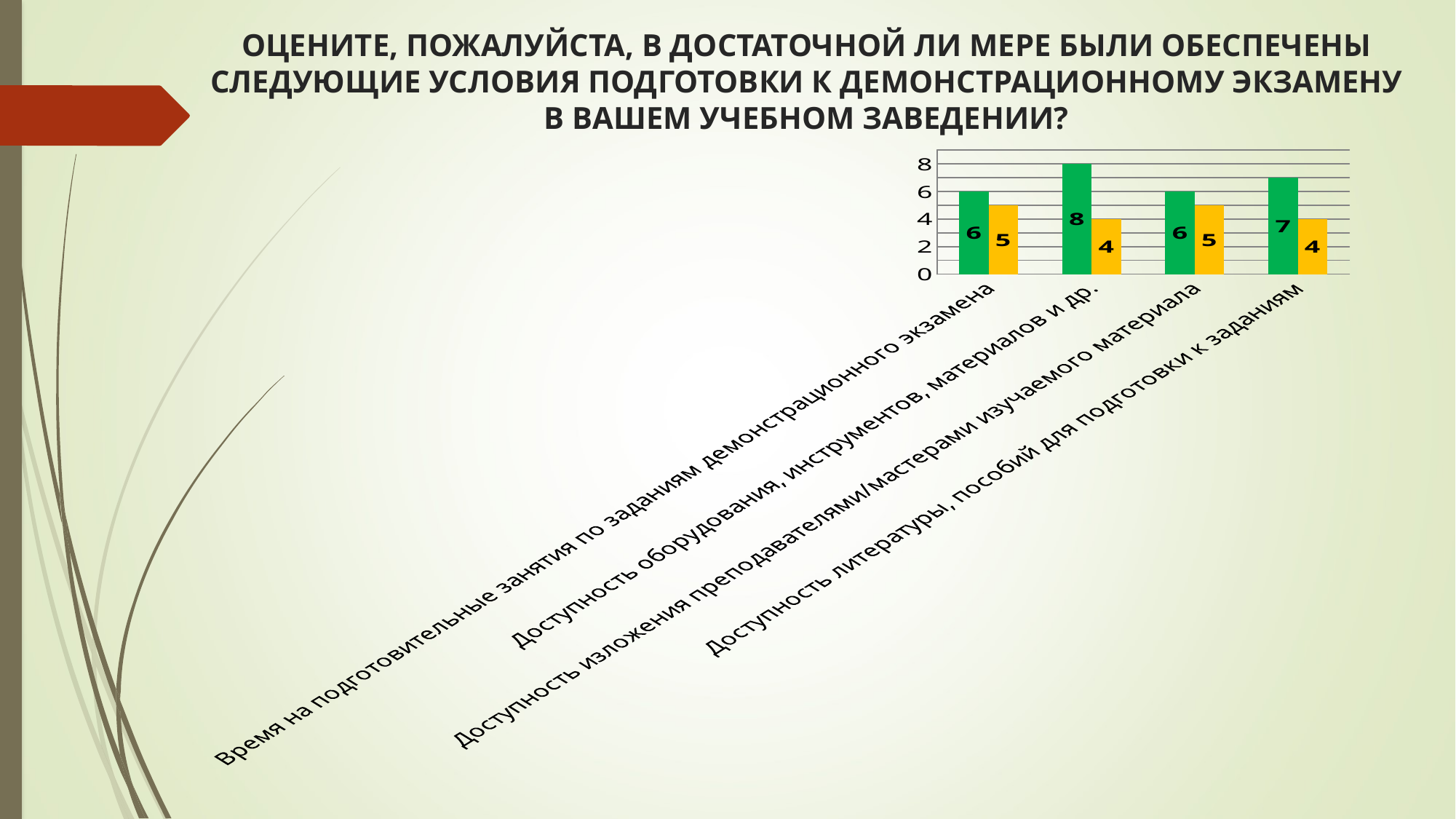
What two colours are used for the bars in the chart? green and yellow What is the value of the yellow bar for "Время на подготовительные занятия по заданиям демонстрационного экзамена"? 5 What is the maximum value shown on the vertical axis of the chart? 8 What kind of chart is shown on the slide? bar chart Which is larger for "Время на подготовительные занятия по заданиям демонстрационного экзамена": the green bar or the yellow bar? the green bar What is the difference between the green and yellow bars for "Доступность оборудования, инструментов, материалов и др."? 4 What is the value of the green bar for "Доступность литературы, пособий для подготовки к заданиям"? 7 Which category has the highest green bar? Доступность оборудования, инструментов, материалов и др. How many categories are shown on the x axis of the chart? 4 What is the difference between the green and yellow bars for "Доступность литературы, пособий для подготовки к заданиям"? 3 What is the value of the yellow bar for "Доступность изложения преподавателями/мастерами изучаемого материала"? 5 What is the value of the green bar for "Доступность оборудования, инструментов, материалов и др."? 8